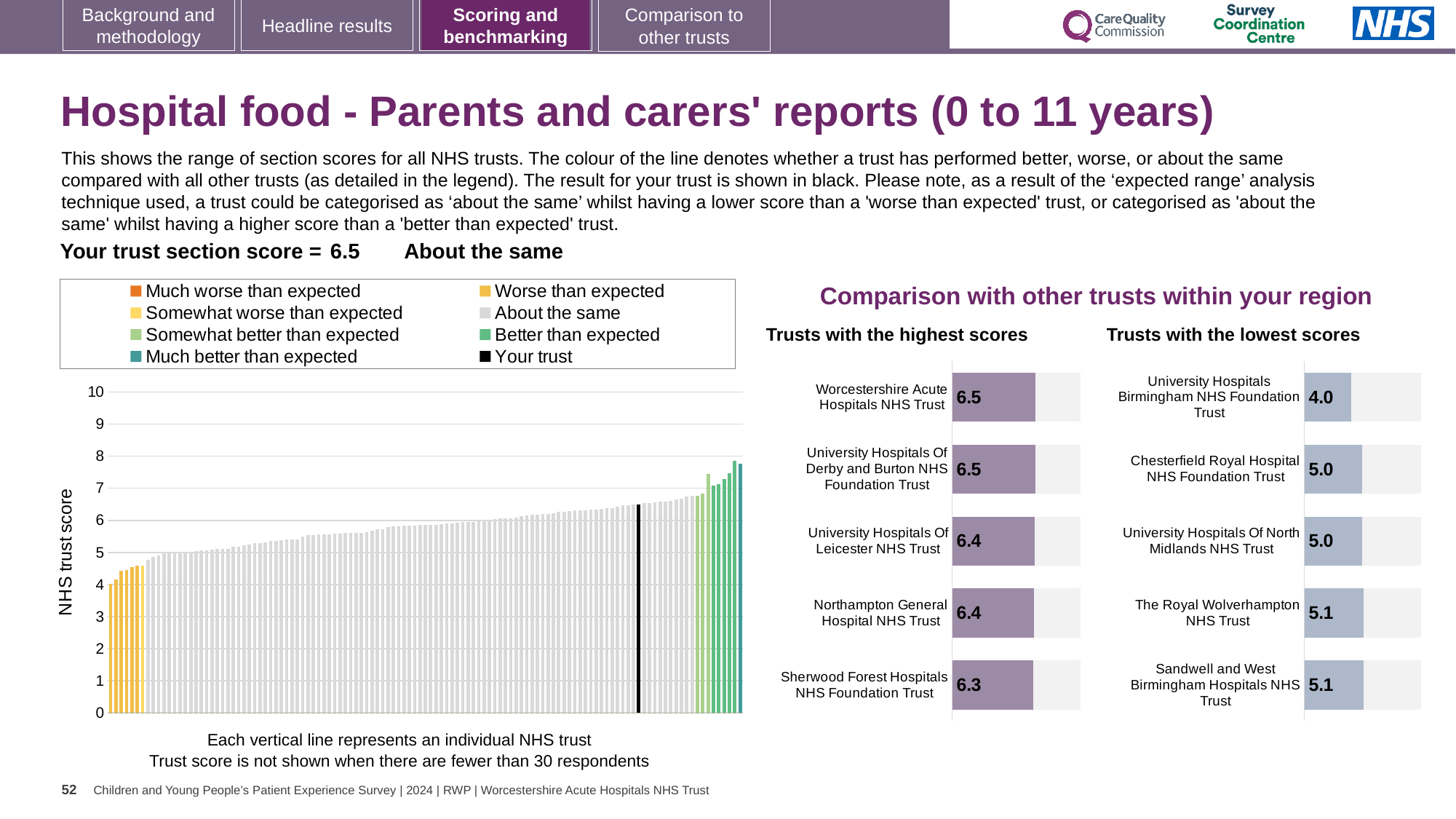
In the main chart of all NHS trusts on the left, do the trust scores rise or fall from left to right? Rise In the 'Trusts with the lowest scores' chart, what is the score for University Hospitals Birmingham NHS Foundation Trust? 4.0 In the 'Trusts with the highest scores' chart, what is the score for Worcestershire Acute Hospitals NHS Trust? 6.5 In the 'Trusts with the highest scores' chart, what is the difference between the scores of Worcestershire Acute Hospitals NHS Trust and Sherwood Forest Hospitals NHS Foundation Trust? 0.2 How many categories does the legend of the main chart on the left list? 8 In the 'Trusts with the highest scores' chart, what is the score for Sherwood Forest Hospitals NHS Foundation Trust? 6.3 In the 'Trusts with the lowest scores' chart, which has the larger score: The Royal Wolverhampton NHS Trust or University Hospitals Birmingham NHS Foundation Trust? The Royal Wolverhampton NHS Trust In the 'Trusts with the lowest scores' chart, which trust has the lowest score? University Hospitals Birmingham NHS Foundation Trust In the 'Trusts with the lowest scores' chart, what is the difference between the scores of Chesterfield Royal Hospital NHS Foundation Trust and University Hospitals Birmingham NHS Foundation Trust? 1.0 In the 'Trusts with the highest scores' chart, which trust has the lowest score? Sherwood Forest Hospitals NHS Foundation Trust In the main chart of all NHS trusts on the left, what kind of chart is it? Bar chart How many trusts are shown in the 'Trusts with the highest scores' chart? 5